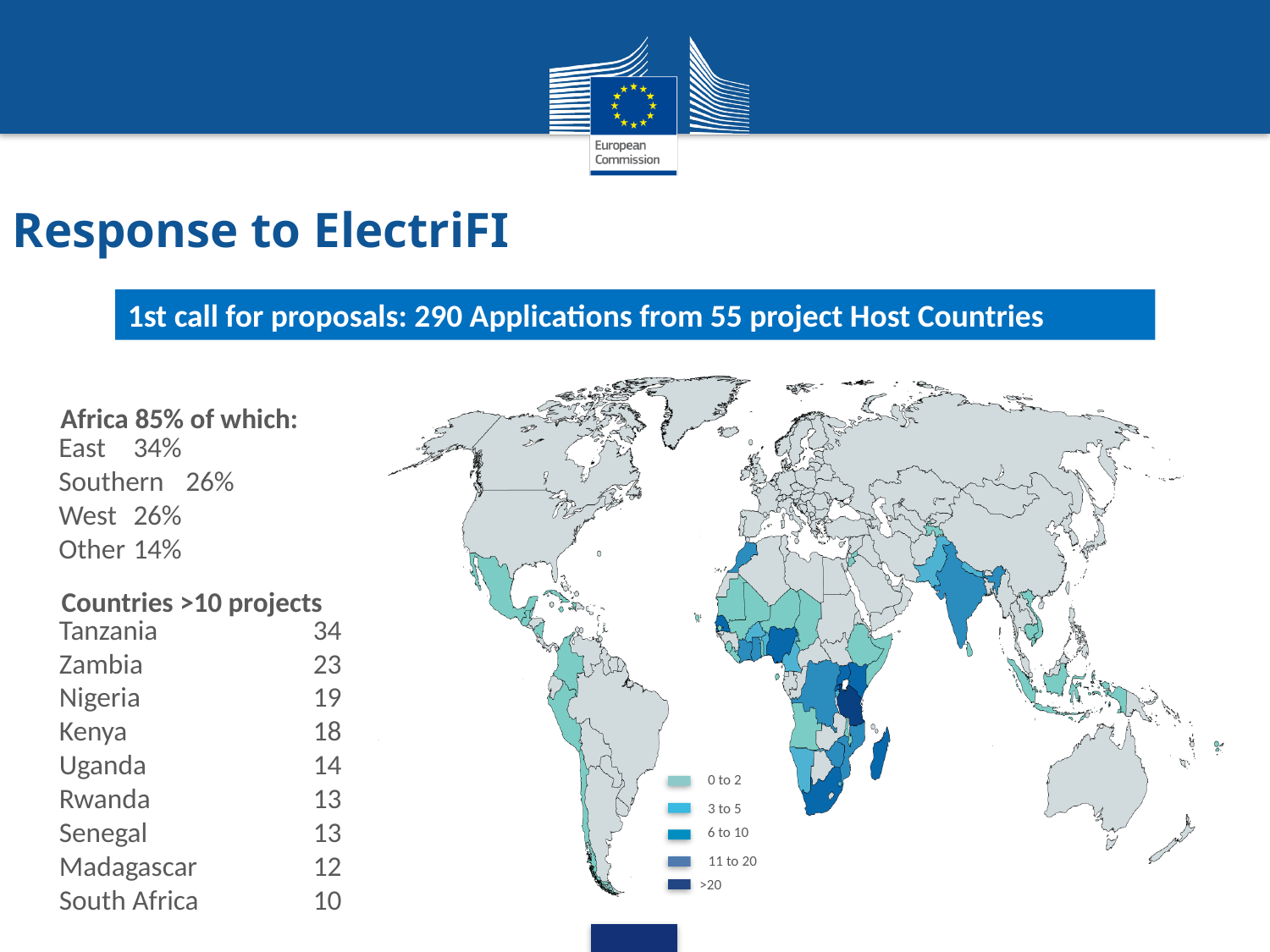
What is the highest value range shown in the map legend? >20 What kind of chart is shown on the slide? A map (choropleth map) What is the difference in the number of projects between Tanzania and Zambia? 11 How many value ranges does the map legend list? 5 Which has more projects, Nigeria or Uganda? Nigeria What is the lowest value range shown in the map legend? 0 to 2 What share of applications came from East Africa according to the slide? 34% According to the list of countries with more than 10 projects, which country has the most projects? Tanzania How many projects does Zambia have according to the slide? 23 How many projects does Kenya have according to the slide? 18 According to the list of countries with more than 10 projects, which country has the fewest projects? South Africa How many countries are listed as having more than 10 projects? 9